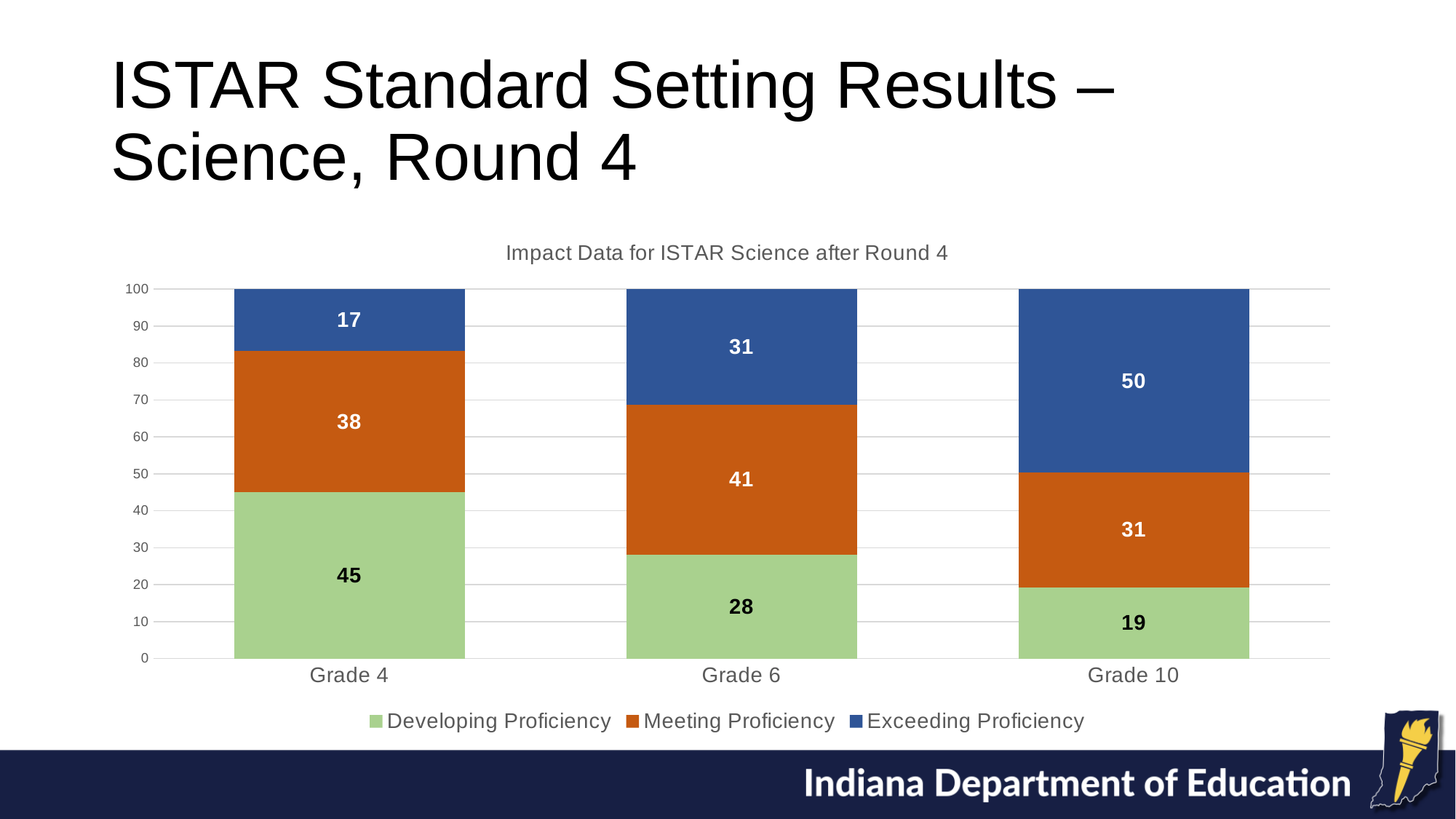
Does the Exceeding Proficiency value rise or fall from Grade 4 to Grade 10? Rise How many series does the legend list? 3 Which grade has the lowest Developing Proficiency value? Grade 10 What is the Meeting Proficiency value for Grade 6? 41 What is the Exceeding Proficiency value for Grade 10? 50 Which grade has the highest Exceeding Proficiency value? Grade 10 What is the difference between the Exceeding Proficiency values for Grade 10 and Grade 4? 33 How many grade categories are shown on the x axis? 3 What is the total of the stacked bar for Grade 6? 100 Which is larger: the Meeting Proficiency value for Grade 4 or for Grade 10? Grade 4 What kind of chart is shown on the slide? Stacked bar chart What is the Developing Proficiency value for Grade 4? 45